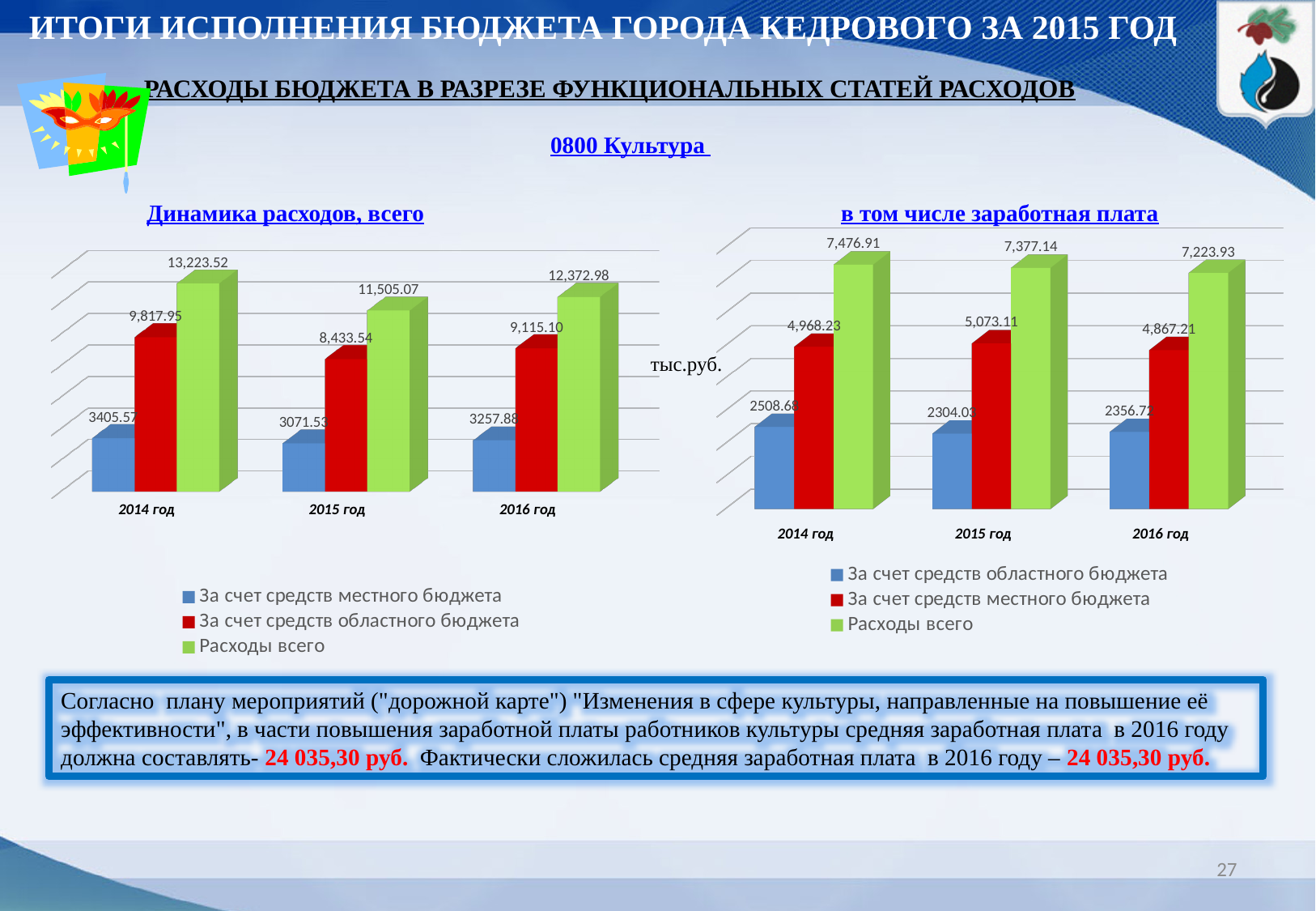
On the chart 'в том числе заработная плата', what is the value of 'За счет средств местного бюджета' for 2016 год? 4,867.21 On the chart 'в том числе заработная плата', which year has the lowest value of 'Расходы всего'? 2016 год On the chart 'Динамика расходов, всего', what is the value of 'Расходы всего' for 2014 год? 13,223.52 On the chart 'в том числе заработная плата', is 'За счет средств местного бюджета' larger in 2015 год or in 2014 год? 2015 год On the chart 'Динамика расходов, всего', which year has the lowest value of 'За счет средств областного бюджета'? 2015 год What type of chart is 'Динамика расходов, всего'? Bar chart On the chart 'Динамика расходов, всего', which year has the highest value of 'Расходы всего'? 2014 год On the chart 'Динамика расходов, всего', what is the difference between 'Расходы всего' for 2016 год and 2015 год? 867.91 On the chart 'Динамика расходов, всего', what is the value of 'За счет средств областного бюджета' for 2015 год? 8,433.54 On the chart 'в том числе заработная плата', how many series does the legend list? 3 On the chart 'в том числе заработная плата', what is the value of 'Расходы всего' for 2015 год? 7,377.14 On the chart 'Динамика расходов, всего', what is the value of 'За счет средств местного бюджета' for 2016 год? 3257.88